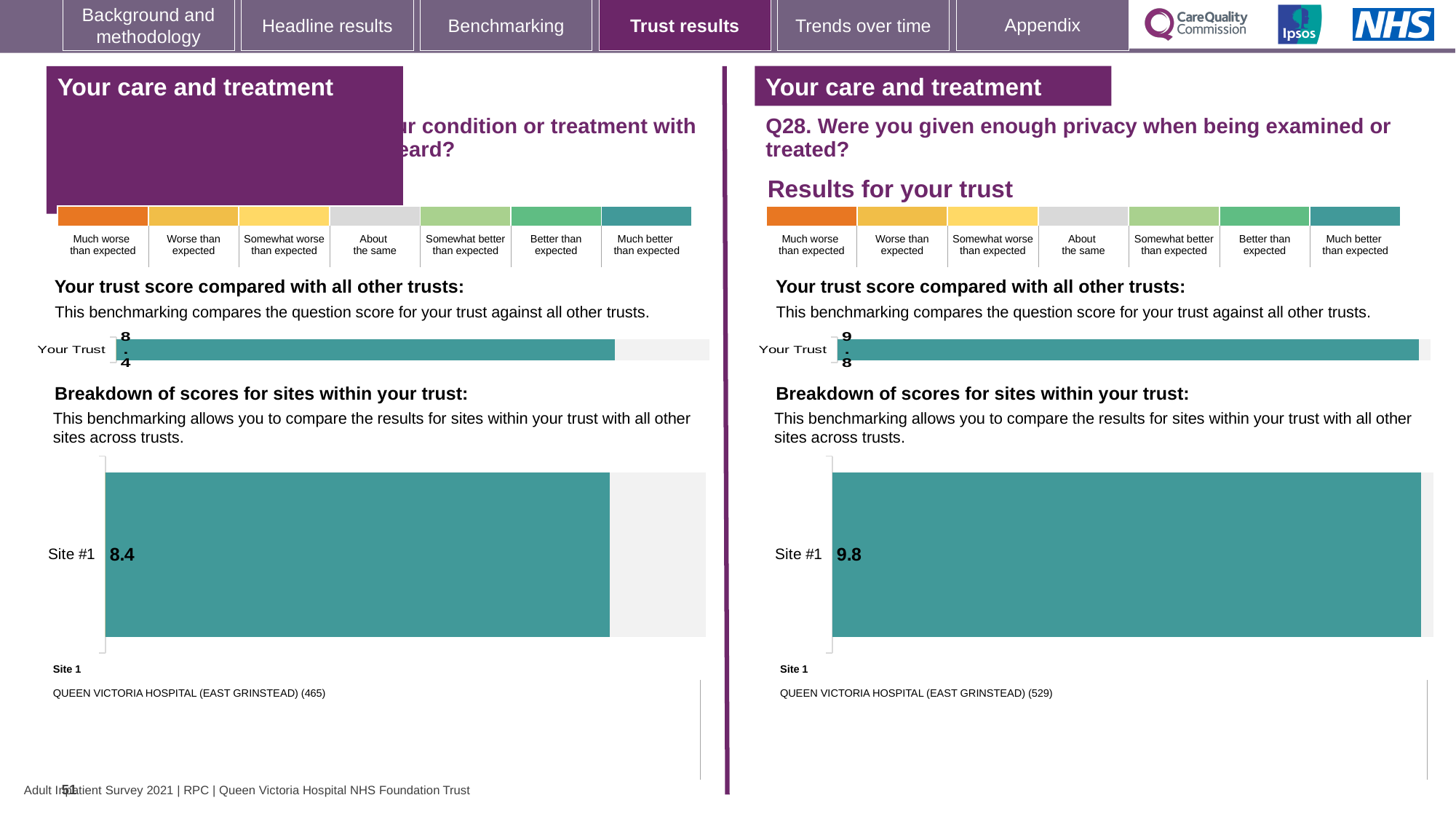
Which is larger: the Site #1 score in the left-hand site breakdown chart or the Site #1 score in the right-hand Q28 site breakdown chart? The right-hand Q28 chart (9.8) On the left-hand 'Your Trust' chart, what score is shown for Your Trust? 8.4 What colour are the bars in the site breakdown charts on this slide? Teal On the right-hand chart for Q28 (privacy when being examined or treated), what is the score shown for Your Trust? 9.8 What is the difference between the Site #1 score in the right-hand Q28 site breakdown chart and the Site #1 score in the left-hand site breakdown chart? 1.4 How many sites are shown in the right-hand Q28 'Breakdown of scores for sites within your trust' chart? 1 Which site is listed as Site 1 beneath the right-hand Q28 site breakdown chart? QUEEN VICTORIA HOSPITAL (EAST GRINSTEAD) (529) What type of chart is used in the right-hand Q28 'Breakdown of scores for sites within your trust' section? Bar chart In the right-hand 'Breakdown of scores for sites within your trust' chart for Q28, what is the score for Site #1? 9.8 How many sites are shown in the left-hand 'Breakdown of scores for sites within your trust' chart? 1 What type of chart is used to show the 'Your Trust' score on the left-hand side of the slide? Bar chart In the left-hand 'Breakdown of scores for sites within your trust' chart, what is the score for Site #1? 8.4